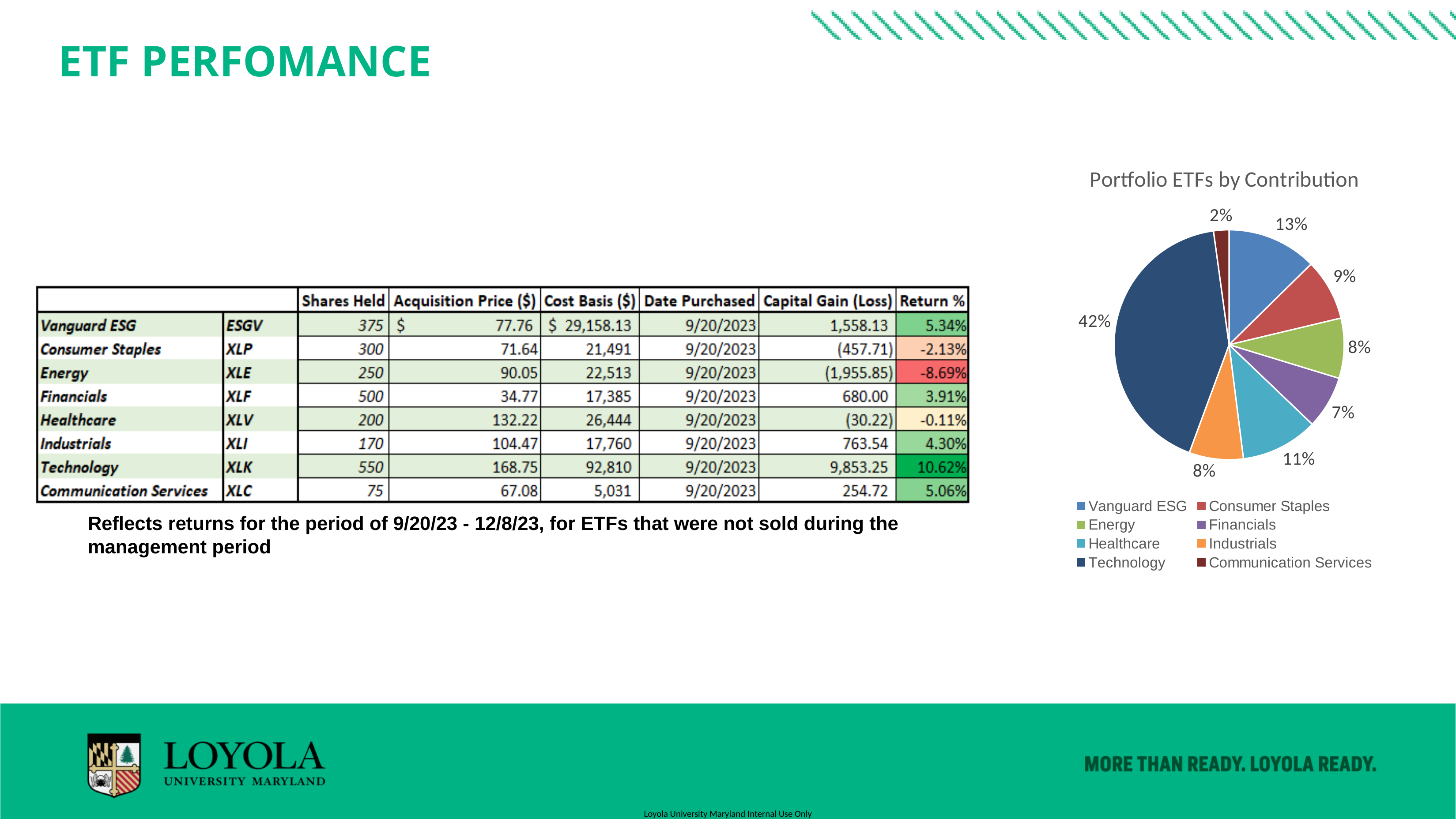
What is the difference in percentage points between the Technology slice and the Vanguard ESG slice? 29 What share of the pie does Vanguard ESG represent? 13% Which ETF has the largest slice of the pie? Technology What type of chart is shown on the slide? pie chart How many slices does the pie chart have? 8 What share of the pie does Healthcare represent? 11% What share of the pie does Communication Services represent? 2% What is the title of the chart? Portfolio ETFs by Contribution Which ETF has the smallest slice of the pie? Communication Services How many entries does the legend list? 8 Which slice is larger, Consumer Staples or Financials? Consumer Staples